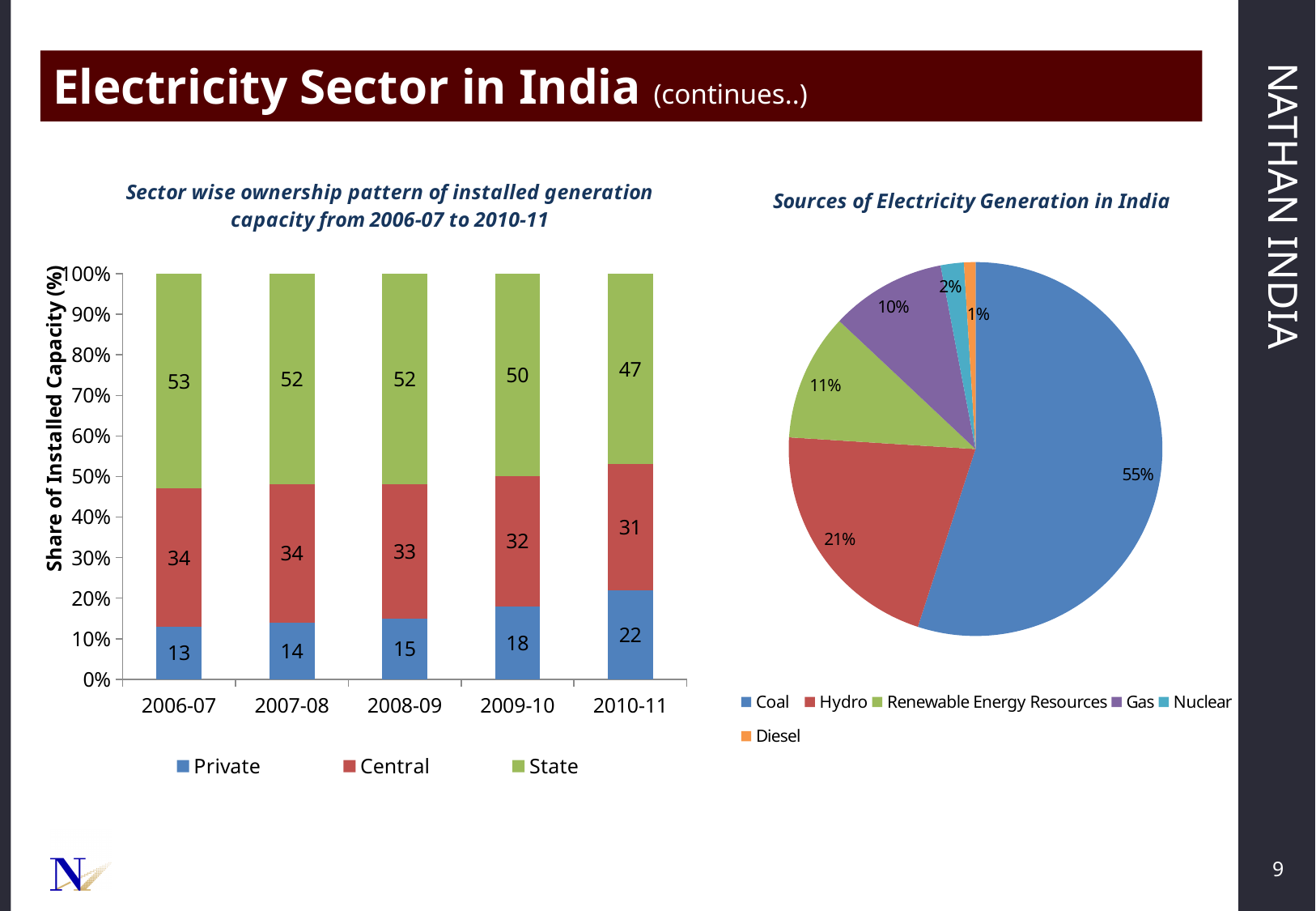
In the 'Sector wise ownership pattern' chart, in which year is the State share lowest? 2010-11 In the 'Sector wise ownership pattern' chart, does the Private share rise or fall from 2006-07 to 2010-11? rise What kind of chart is 'Sources of Electricity Generation in India'? pie chart How many sources does the legend of the 'Sources of Electricity Generation in India' pie chart list? 6 In the 'Sector wise ownership pattern' chart, what is the State share in 2006-07? 53 In the 'Sector wise ownership pattern' chart, in which year is the Private share highest? 2010-11 In the 'Sector wise ownership pattern' chart, what is the Private share in 2010-11? 22 In the 'Sources of Electricity Generation in India' pie chart, what share does Hydro have? 21% In the 'Sources of Electricity Generation in India' pie chart, which source has the largest share? Coal How many series does the legend of the 'Sector wise ownership pattern' chart list? 3 In the 'Sector wise ownership pattern' chart, what is the difference between the State share and the Private share in 2009-10? 32 In the 'Sector wise ownership pattern' chart, what is the Central share in 2008-09? 33